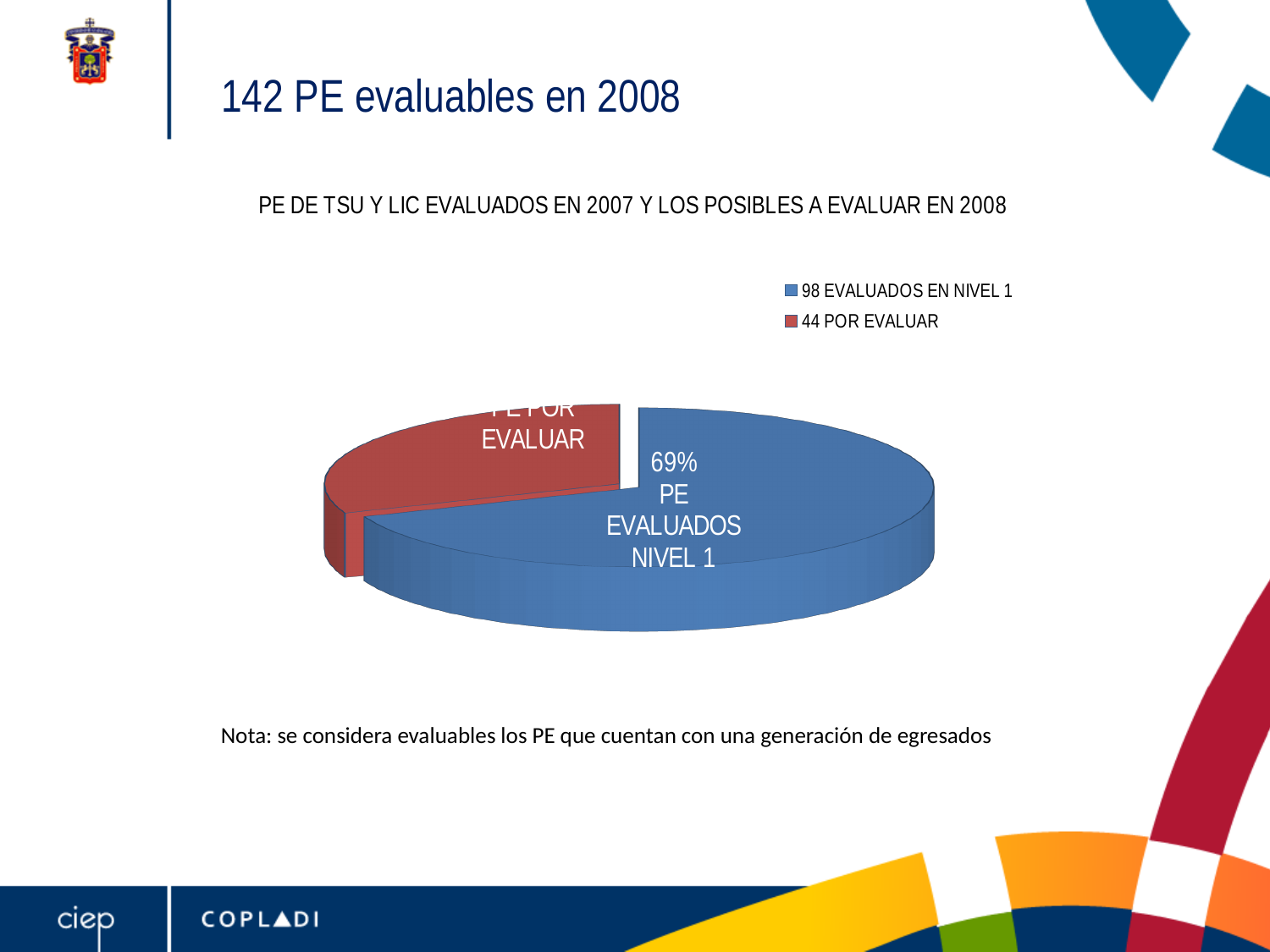
How many entries does the legend of the pie chart list? 2 According to the legend, how many PE are POR EVALUAR? 44 What is the difference between the number of PE EVALUADOS EN NIVEL 1 and the number POR EVALUAR? 54 How many slices does the pie chart have? 2 According to the legend, how many PE were EVALUADOS EN NIVEL 1? 98 What colour is the POR EVALUAR slice of the pie chart? red Which slice of the pie chart is the largest? PE EVALUADOS NIVEL 1 Which slice of the pie chart is the smallest? PE POR EVALUAR Which is larger, the number of PE EVALUADOS EN NIVEL 1 or the number POR EVALUAR? EVALUADOS EN NIVEL 1 What kind of chart is shown on the slide? pie chart What percentage of the pie is labelled for PE EVALUADOS NIVEL 1? 69% What is the total number of PE represented in the pie chart (98 plus 44)? 142